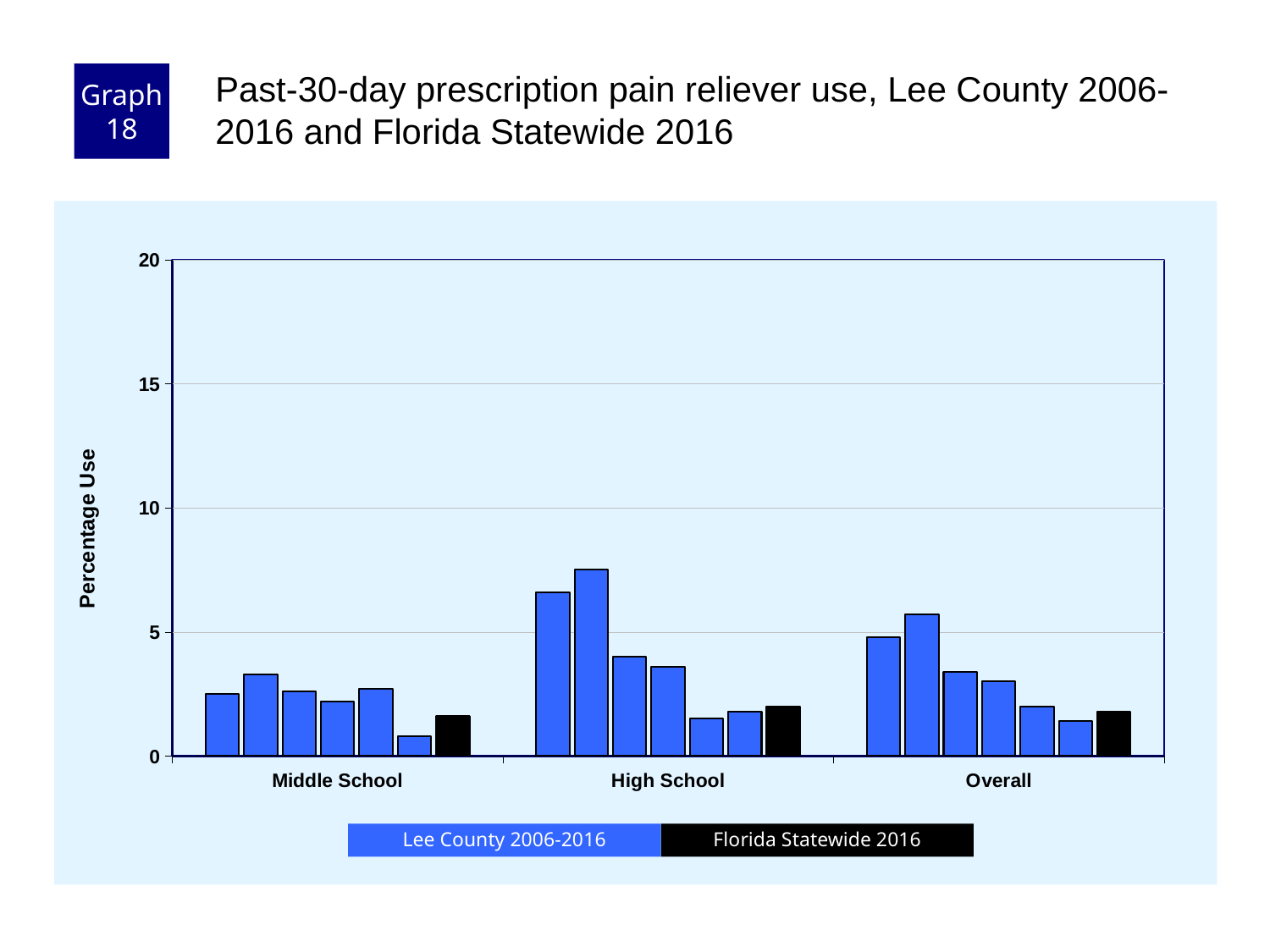
Which colour represents Florida Statewide 2016 in the legend? black Is the tallest Lee County 2006-2016 bar for High School greater or less than 10? less Is the tallest Lee County 2006-2016 bar for High School greater or less than 5? greater What is the label on the y axis? Percentage Use How many series does the legend list? 2 What kind of chart is shown on the slide? bar chart Which is larger: the tallest bar in the High School group or the tallest bar in the Overall group? High School Is the tallest Lee County 2006-2016 bar for Middle School greater or less than 5? less Which is larger: the Florida Statewide 2016 bar for Middle School or the tallest Lee County 2006-2016 bar for Middle School? the tallest Lee County 2006-2016 bar How many school-level categories are shown on the x axis? 3 Which category group contains the tallest bar on the chart? High School